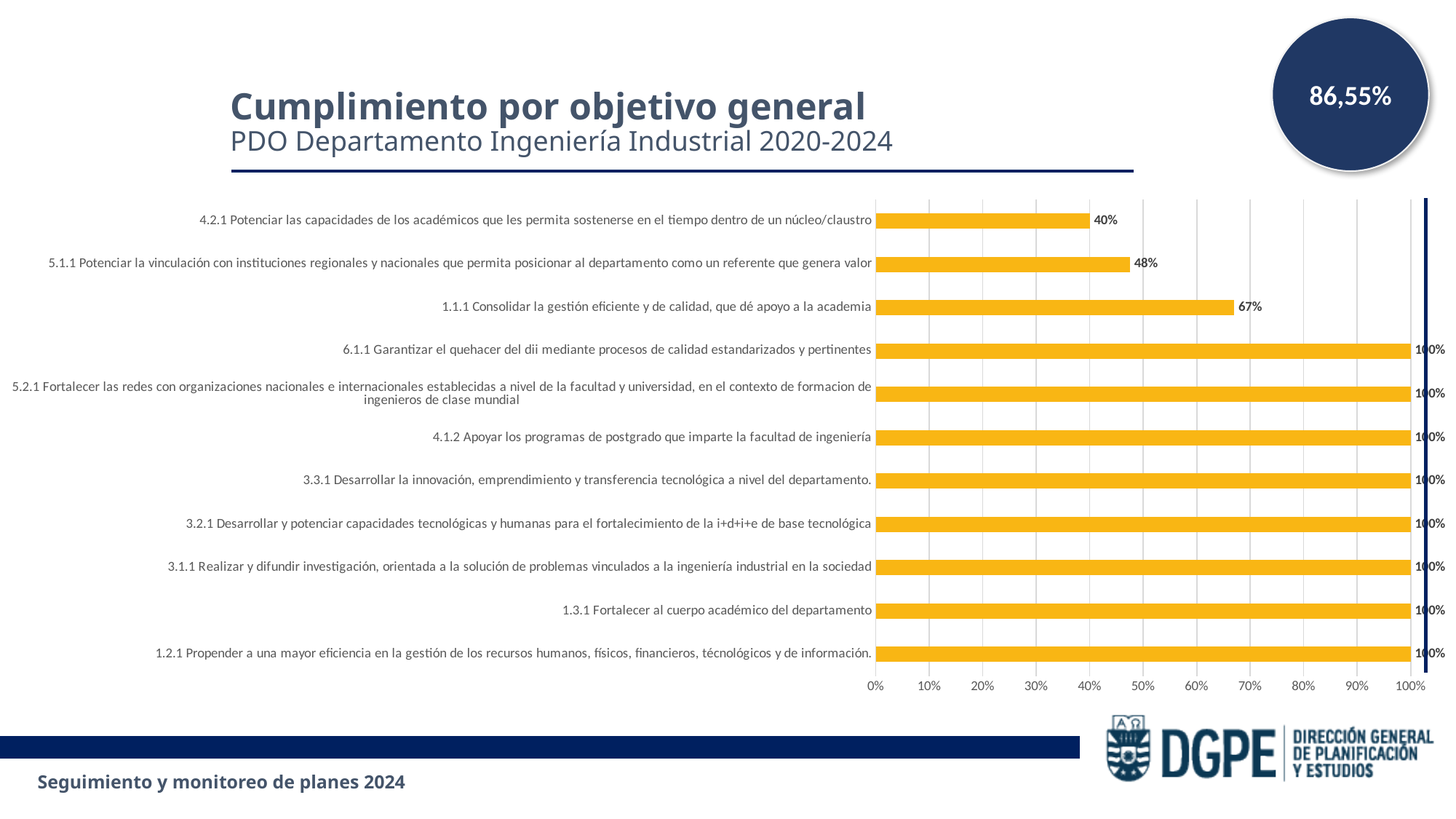
What kind of chart is shown on the slide? Bar chart Is the value for objective 1.1.1 greater or less than 60%? greater What is the value for objective 1.1.1 (Consolidar la gestión eficiente y de calidad)? 67% What is the value for objective 4.2.1 (Potenciar las capacidades de los académicos)? 40% What is the value for objective 5.1.1 (Potenciar la vinculación con instituciones regionales y nacionales)? 48% Which objective has the lowest value? 4.2.1 Potenciar las capacidades de los académicos que les permita sostenerse en el tiempo dentro de un núcleo/claustro How many objectives have a value of 100%? 8 What is the difference between the values for objective 1.1.1 and objective 4.2.1? 27% What is the difference between the values for objective 5.1.1 and objective 4.2.1? 8% Which is larger, the value for objective 5.1.1 or the value for objective 1.1.1? 1.1.1 How many objectives (bars) are shown in the chart? 11 What is the value for objective 1.3.1 (Fortalecer al cuerpo académico del departamento)? 100%